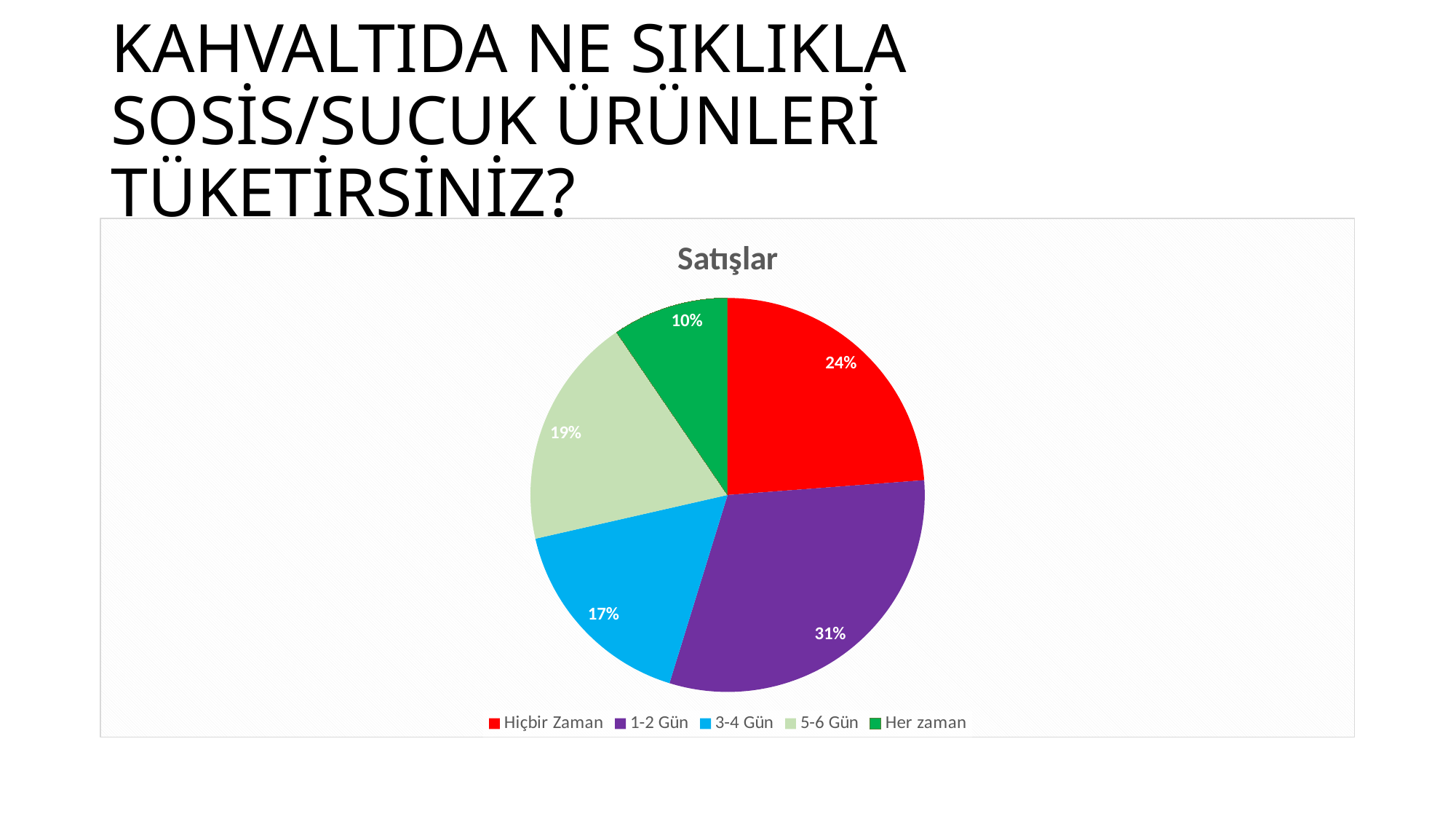
Which category has the largest slice of the pie? 1-2 Gün What percentage is shown for the 'Her zaman' slice? 10% What percentage is shown for the 'Hiçbir Zaman' slice? 24% Which category has the smallest slice of the pie? Her zaman What is the difference in percentage points between the '1-2 Gün' slice and the 'Hiçbir Zaman' slice? 7 What percentage is shown for the '1-2 Gün' slice? 31% What is the chart's title? Satışlar What kind of chart is shown on the slide? pie chart What percentage is shown for the '3-4 Gün' slice? 17% What percentage is shown for the '5-6 Gün' slice? 19% Which slice is larger, '5-6 Gün' or '3-4 Gün'? 5-6 Gün How many categories does the legend list? 5